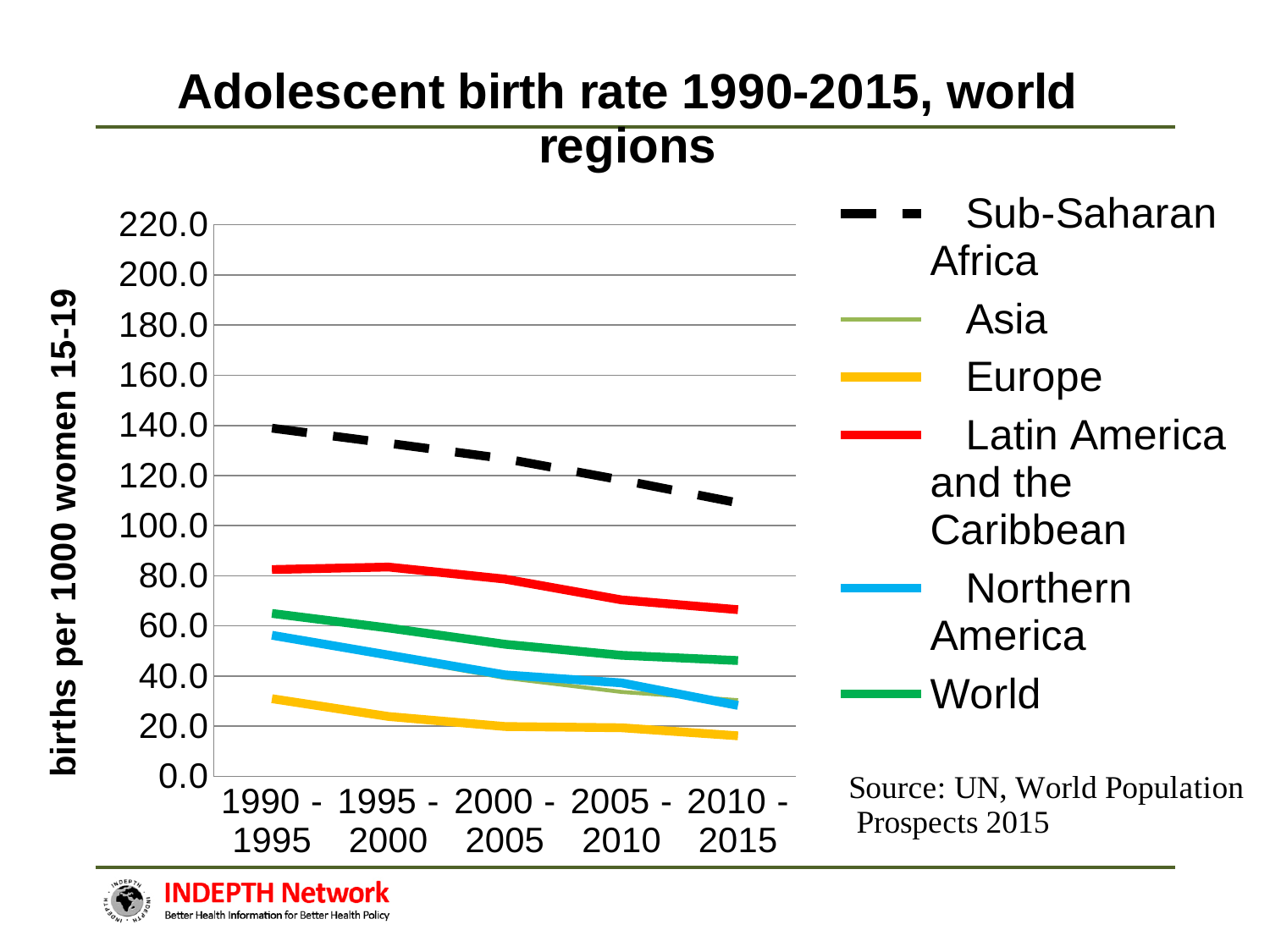
Does the Sub-Saharan Africa line rise or fall from 1990 - 1995 to 2010 - 2015? fall How many series does the legend list? 6 In 2010 - 2015, which is larger: the value for Latin America and the Caribbean or the value for Northern America? Latin America and the Caribbean How many time periods are shown along the x axis? 5 What kind of chart is shown on the slide? line chart Is the value for Northern America in 1990 - 1995 greater or less than 40.0? greater Is the value for Sub-Saharan Africa in 1990 - 1995 greater or less than 120.0? greater Is the value for Sub-Saharan Africa in 2010 - 2015 greater or less than 120.0? less Which region has the highest adolescent birth rate across all periods? Sub-Saharan Africa What is the label on the y axis? births per 1000 women 15-19 Which region has the lowest adolescent birth rate in 1990 - 1995? Europe